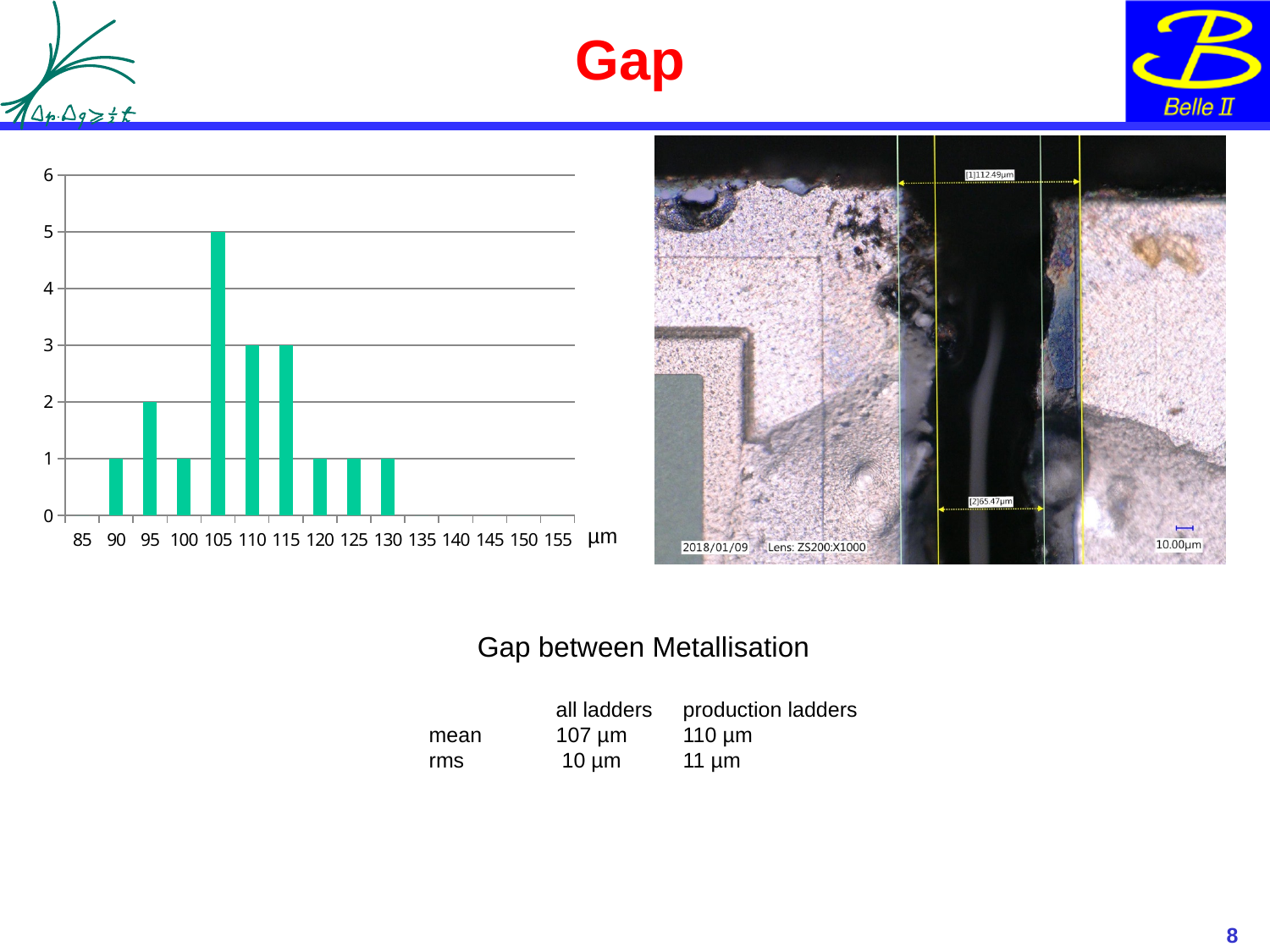
What is the unit label shown at the end of the x axis? µm What kind of chart is shown on the left of the slide? bar chart Which is larger, the bar at 95 µm or the bar at 100 µm? 95 µm Which x-axis category has the highest bar? 105 How many categories have a non-zero bar? 9 What is the value of the bar at 110 µm? 3 What is the difference between the bar at 105 µm and the bar at 110 µm? 2 What is the value of the bar at 105 µm? 5 How many x-axis categories are labelled on the chart? 15 What is the value of the bar at 95 µm? 2 What is the highest value shown on the y axis? 6 What is the value of the bar at 120 µm? 1